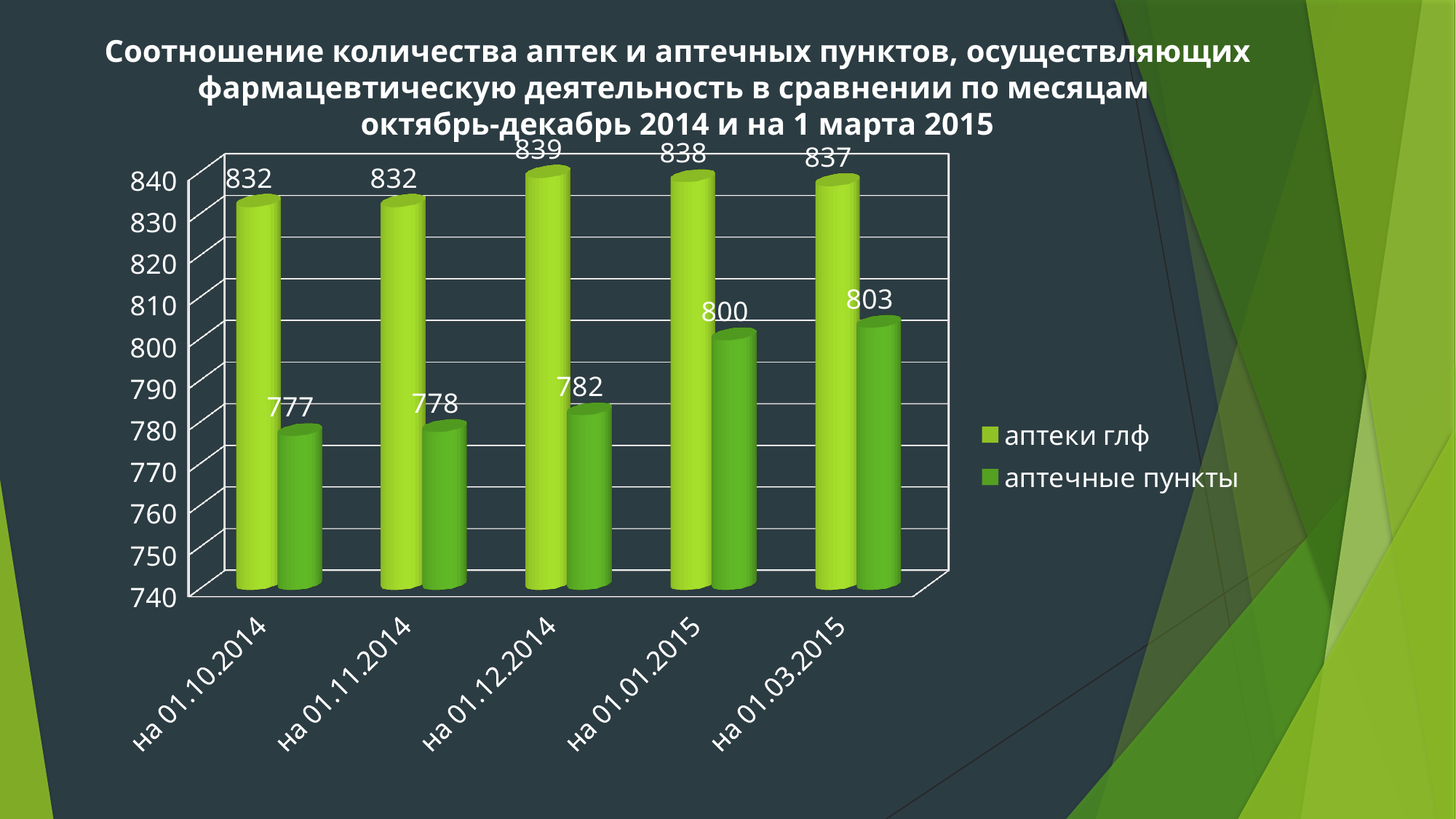
On which date is the value for аптеки глф the highest? на 01.12.2014 What is the value for аптечные пункты on 01.10.2014? 777 What is the value for аптеки глф on 01.12.2014? 839 How many series does the legend list? 2 What kind of chart is shown on the slide? bar chart Which is larger on 01.11.2014: аптеки глф or аптечные пункты? аптеки глф Do the values for аптечные пункты rise or fall from 01.10.2014 to 01.03.2015? rise What is the difference between the аптечные пункты values on 01.03.2015 and 01.10.2014? 26 What is the difference between аптеки глф and аптечные пункты on 01.01.2015? 38 On which date is the value for аптечные пункты the lowest? на 01.10.2014 What is the value for аптечные пункты on 01.03.2015? 803 How many dates are shown on the x axis? 5